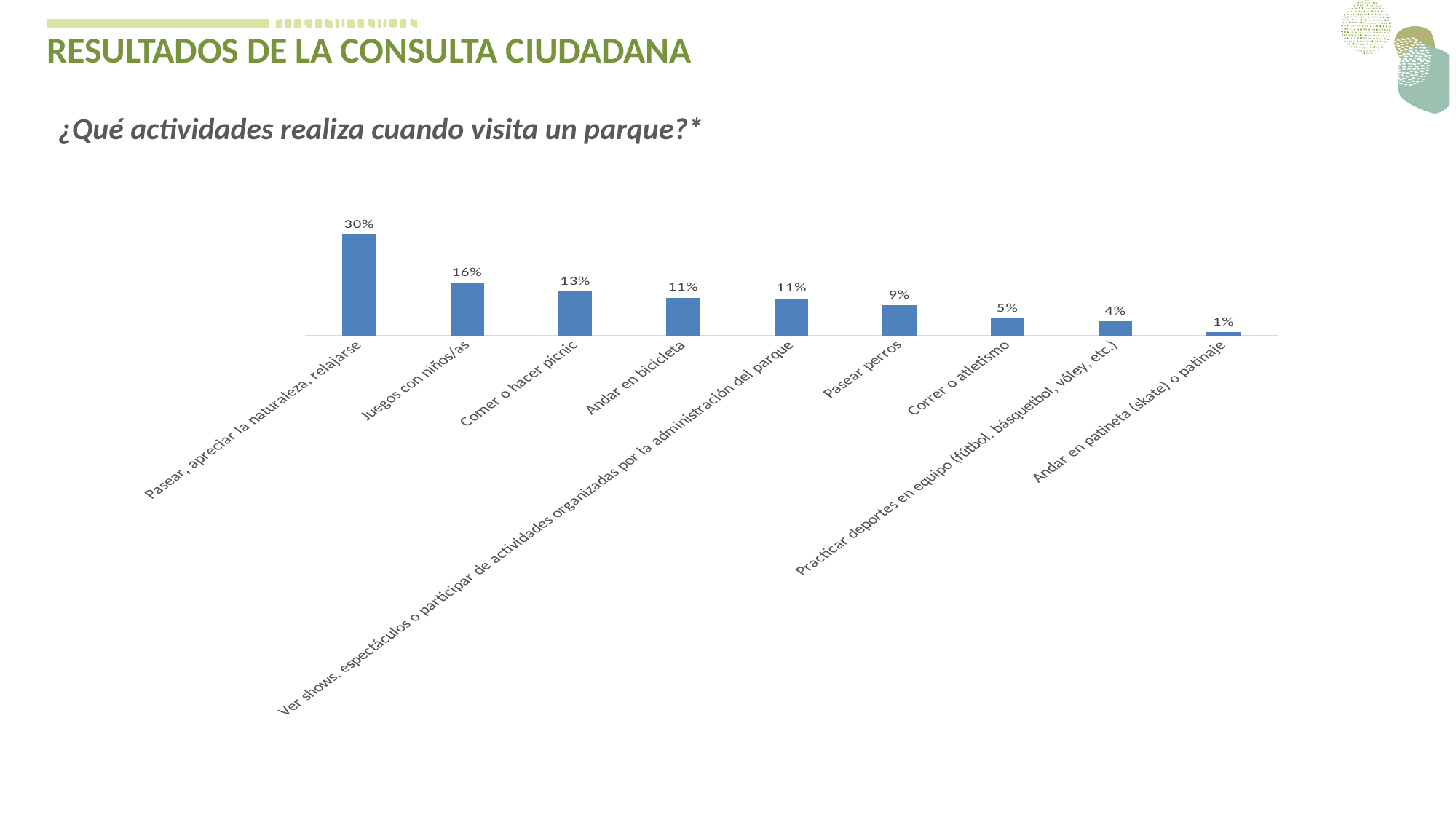
What kind of chart is shown on the slide? Bar chart What is the value for "Andar en patineta (skate) o patinaje"? 1% Which activity has the lowest value? Andar en patineta (skate) o patinaje How many activity categories are shown in the chart? 9 What is the value for "Pasear perros"? 9% Which activity has the highest value? Pasear, apreciar la naturaleza, relajarse Do the values rise or fall from left to right along the x axis? Fall What is the difference between "Pasear, apreciar la naturaleza, relajarse" and "Juegos con niños/as"? 14% Which is larger, "Comer o hacer picnic" or "Correr o atletismo"? Comer o hacer picnic What is the value for "Pasear, apreciar la naturaleza, relajarse"? 30% What question does the chart answer, as stated above it? ¿Qué actividades realiza cuando visita un parque?* What is the value for "Juegos con niños/as"? 16%